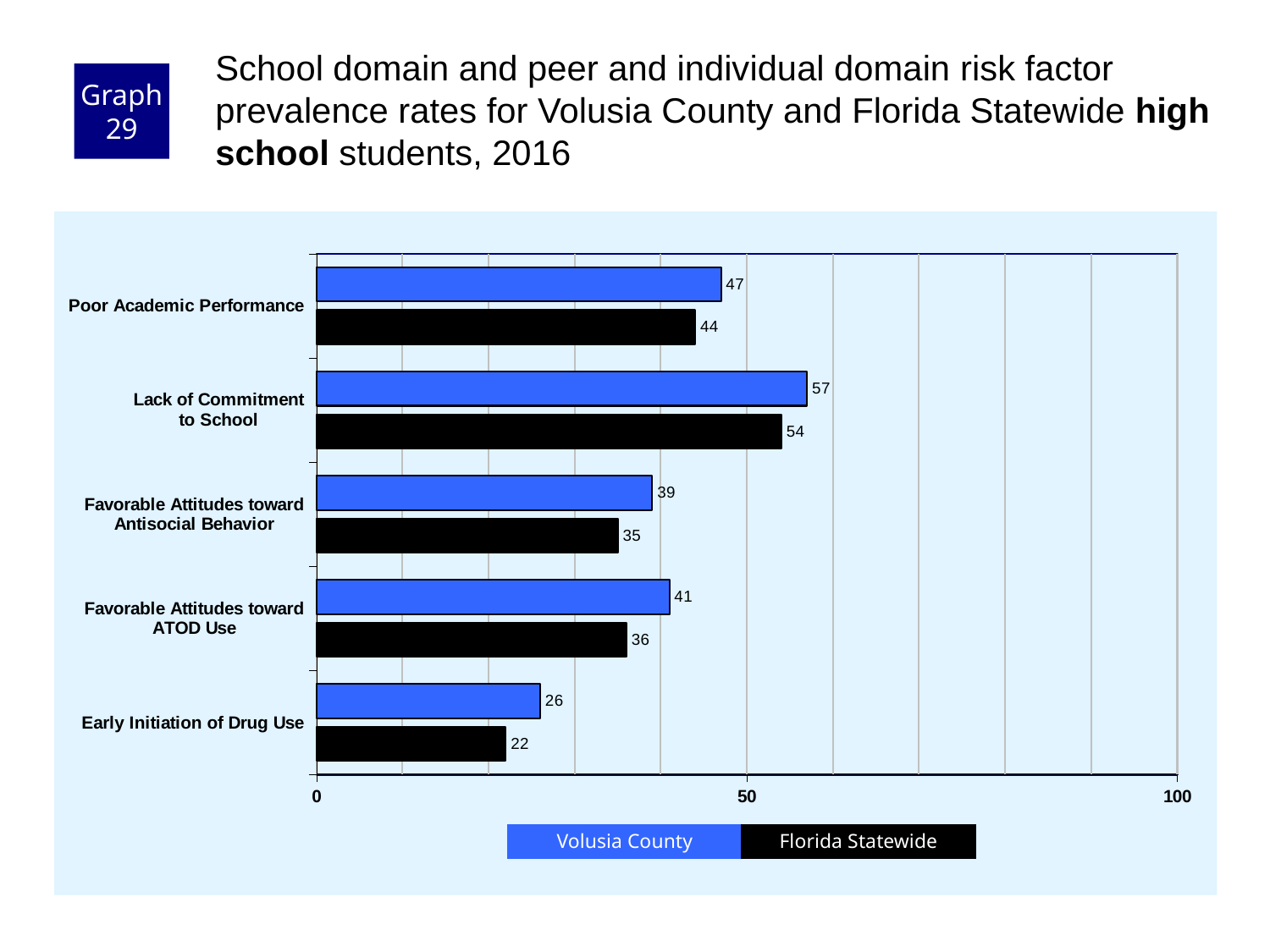
How many series does the legend list? 2 Which risk factor has the highest Volusia County value? Lack of Commitment to School Which is larger for Favorable Attitudes toward Antisocial Behavior: the Volusia County value or the Florida Statewide value? Volusia County What is the difference between the Volusia County and Florida Statewide values for Poor Academic Performance? 3 What is the difference between the Volusia County and Florida Statewide values for Favorable Attitudes toward ATOD Use? 5 What kind of chart is shown on the slide? Bar chart Is the Florida Statewide value for Lack of Commitment to School greater or less than 50? greater How many risk factors are shown on the chart? 5 What is the Florida Statewide value for Early Initiation of Drug Use? 22 What is the Florida Statewide value for Favorable Attitudes toward ATOD Use? 36 Which risk factor has the lowest Florida Statewide value? Early Initiation of Drug Use What is the Volusia County value for Lack of Commitment to School? 57